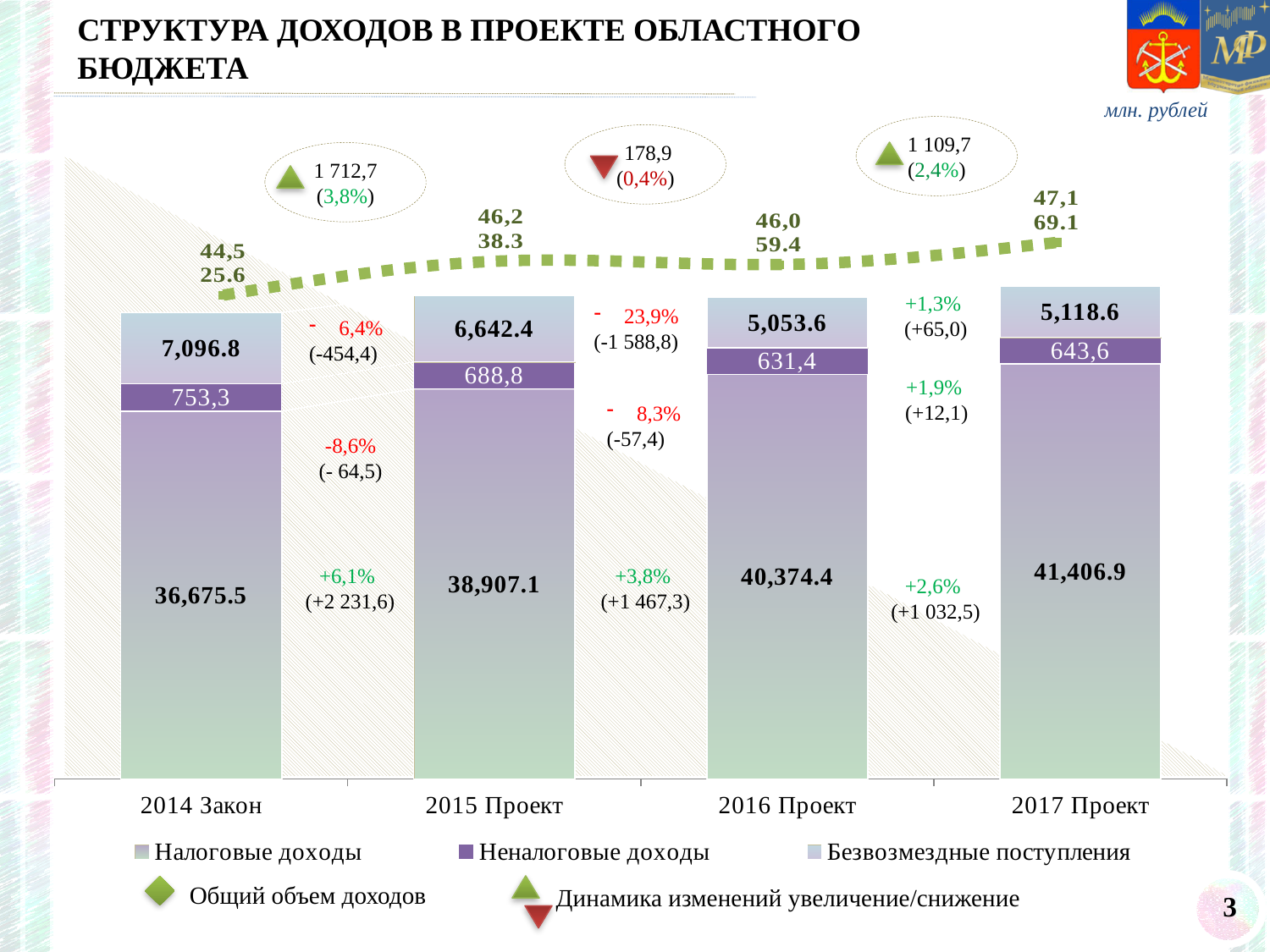
Does Налоговые доходы rise or fall from 2014 Закон to 2017 Проект? rise How many stacked series make up each bar according to the legend? 3 In which year is Безвозмездные поступления lowest? 2016 Проект In what units are the values on the chart expressed? млн. рублей What is the value of Неналоговые доходы for 2015 Проект? 688,8 What is the value of Налоговые доходы for 2014 Закон? 36,675.5 What is the value of Безвозмездные поступления for 2016 Проект? 5,053.6 How many years (categories) are shown on the x axis? 4 What is the difference between Неналоговые доходы in 2014 Закон and 2015 Проект? 64,5 Which is larger: Неналоговые доходы in 2014 Закон or in 2017 Проект? 2014 Закон In which year is Налоговые доходы highest? 2017 Проект What kind of chart is shown on the slide? bar chart